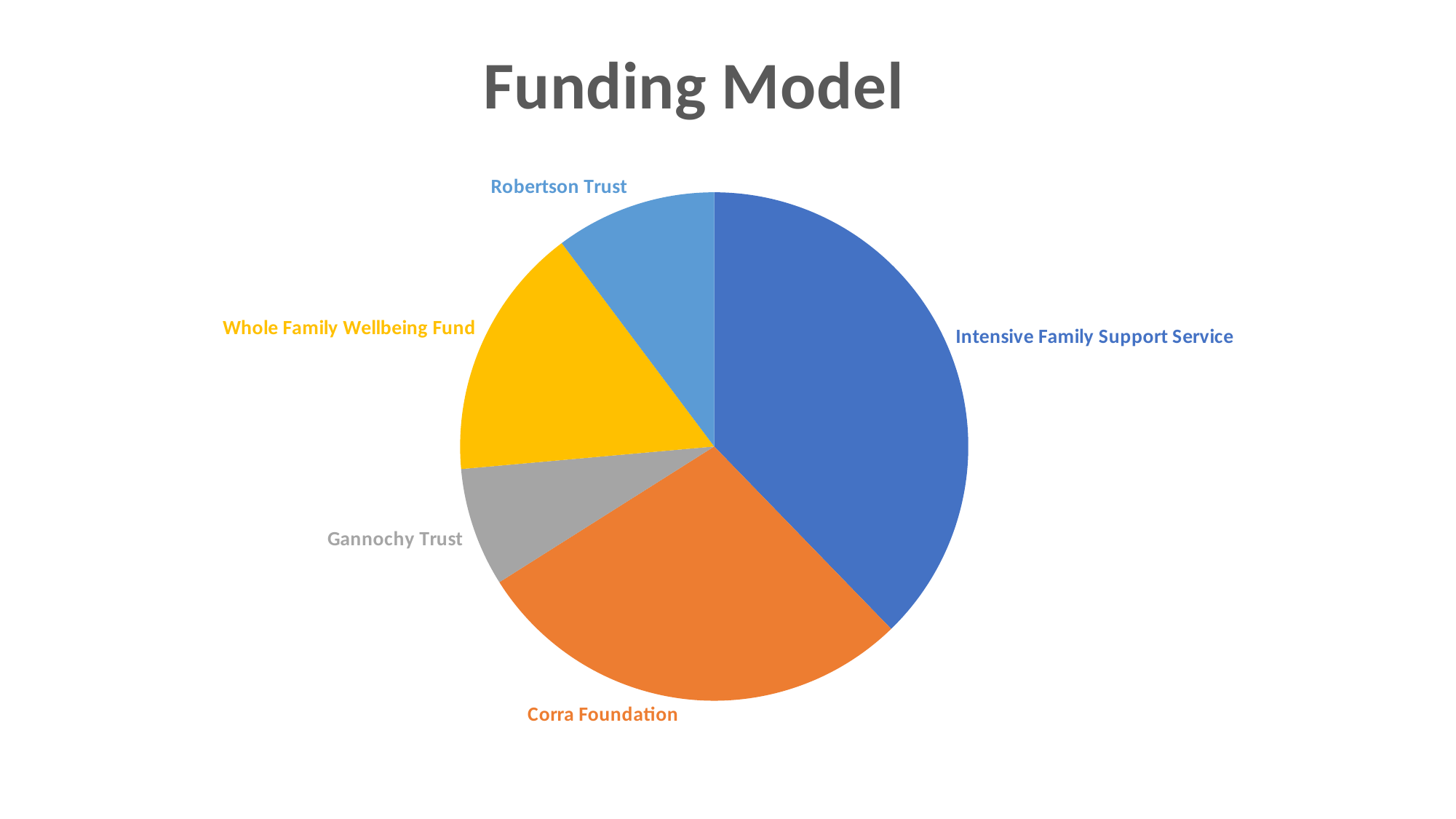
Which funding source has the second-largest slice of the pie? Corra Foundation Which funding source has the largest slice of the pie? Intensive Family Support Service Which slice is larger, Robertson Trust or Gannochy Trust? Robertson Trust How many slices does the pie chart have? 5 What colour is the Corra Foundation slice? Orange Which slice is larger, Corra Foundation or Intensive Family Support Service? Intensive Family Support Service Which funding source has the smallest slice of the pie? Gannochy Trust Which slice is larger, Whole Family Wellbeing Fund or Robertson Trust? Whole Family Wellbeing Fund What is the title of the chart? Funding Model What kind of chart is shown on the slide? Pie chart